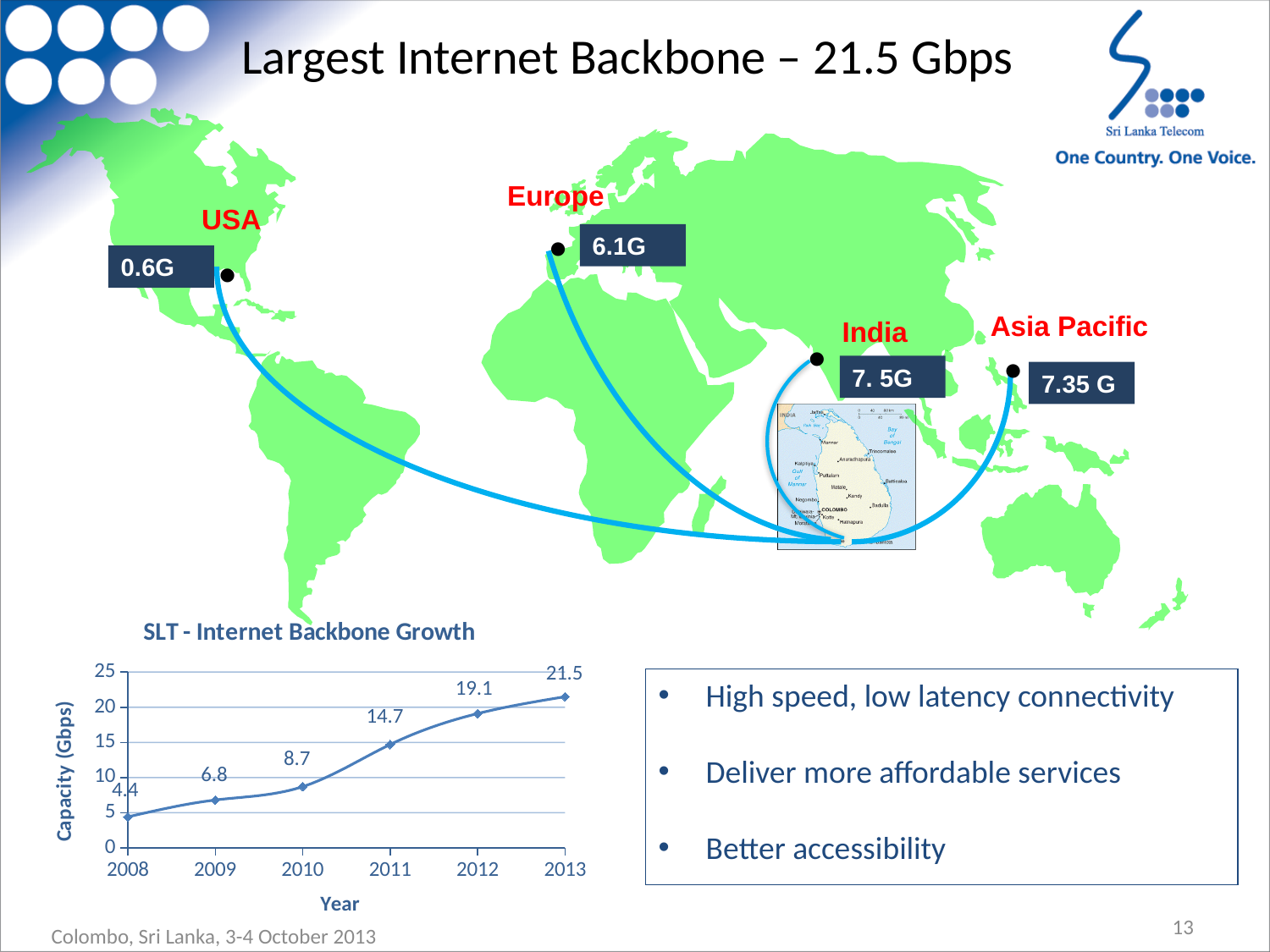
What is the capacity value for 2011 in the SLT - Internet Backbone Growth chart? 14.7 Which year has a larger capacity in the SLT - Internet Backbone Growth chart, 2009 or 2010? 2010 What is the label of the y-axis in the SLT - Internet Backbone Growth chart? Capacity (Gbps) What type of chart is shown on the slide? line chart Does the capacity rise or fall from 2008 to 2013 in the SLT - Internet Backbone Growth chart? rise Which year has the lowest capacity in the SLT - Internet Backbone Growth chart? 2008 What is the title of the chart on the slide? SLT - Internet Backbone Growth Which year has the highest capacity in the SLT - Internet Backbone Growth chart? 2013 What is the capacity value for 2008 in the SLT - Internet Backbone Growth chart? 4.4 What is the capacity value for 2013 in the SLT - Internet Backbone Growth chart? 21.5 How many years are plotted in the SLT - Internet Backbone Growth chart? 6 What is the difference in capacity between 2012 and 2011 in the SLT - Internet Backbone Growth chart? 4.4